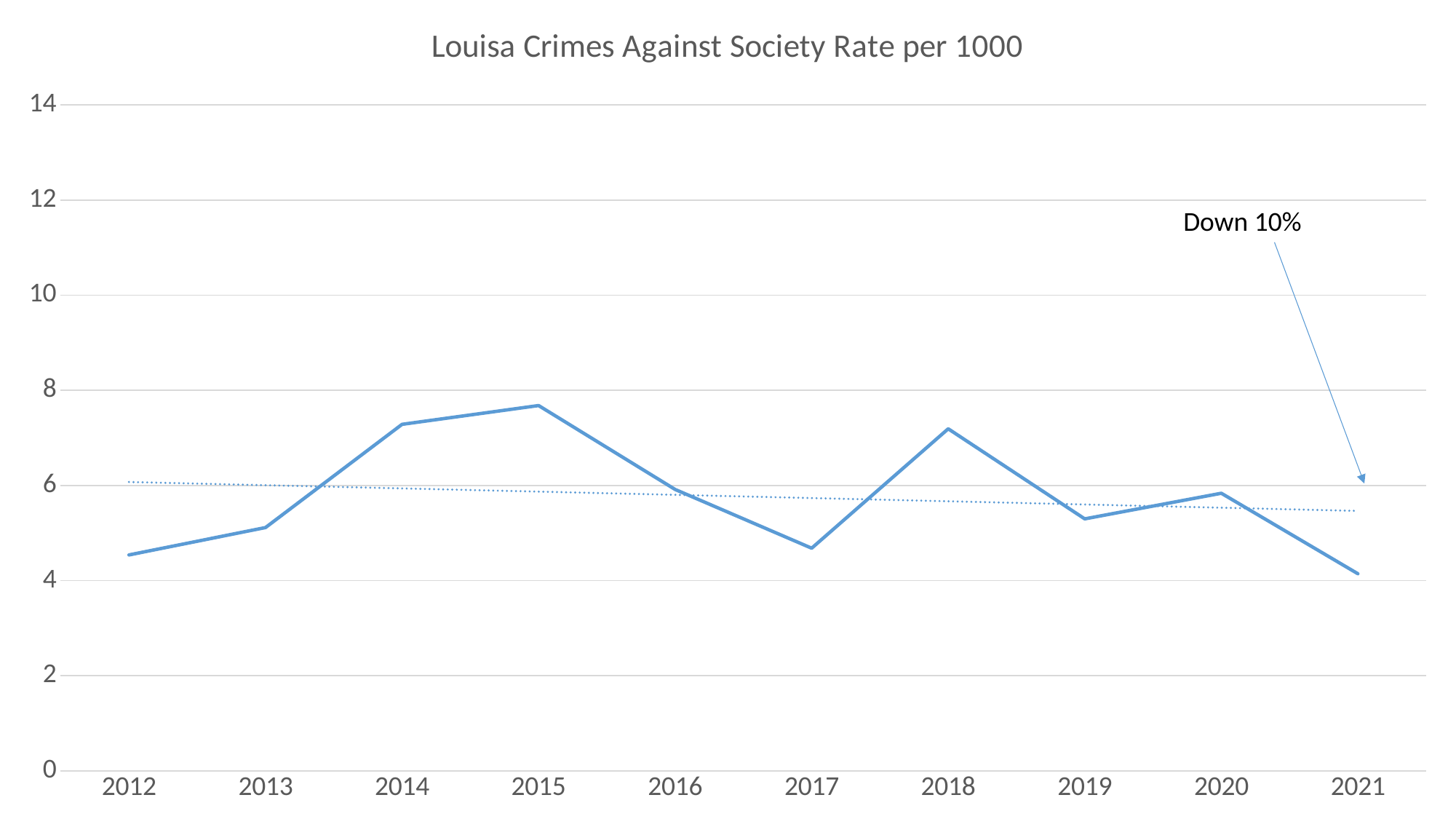
How many years are plotted along the x axis? 10 What is the title of the chart? Louisa Crimes Against Society Rate per 1000 What does the annotation pointing to the end of the trend line say? Down 10% Which year has the lowest crimes against society rate? 2021 Does the rate rise or fall from 2018 to 2019? fall Is the value for 2015 greater or less than 6? greater Which year has the highest crimes against society rate? 2015 Which year has the higher rate, 2014 or 2017? 2014 Is the value for 2021 greater or less than 6? less Is the value for 2018 greater or less than 6? greater What kind of chart is shown on the slide? line chart